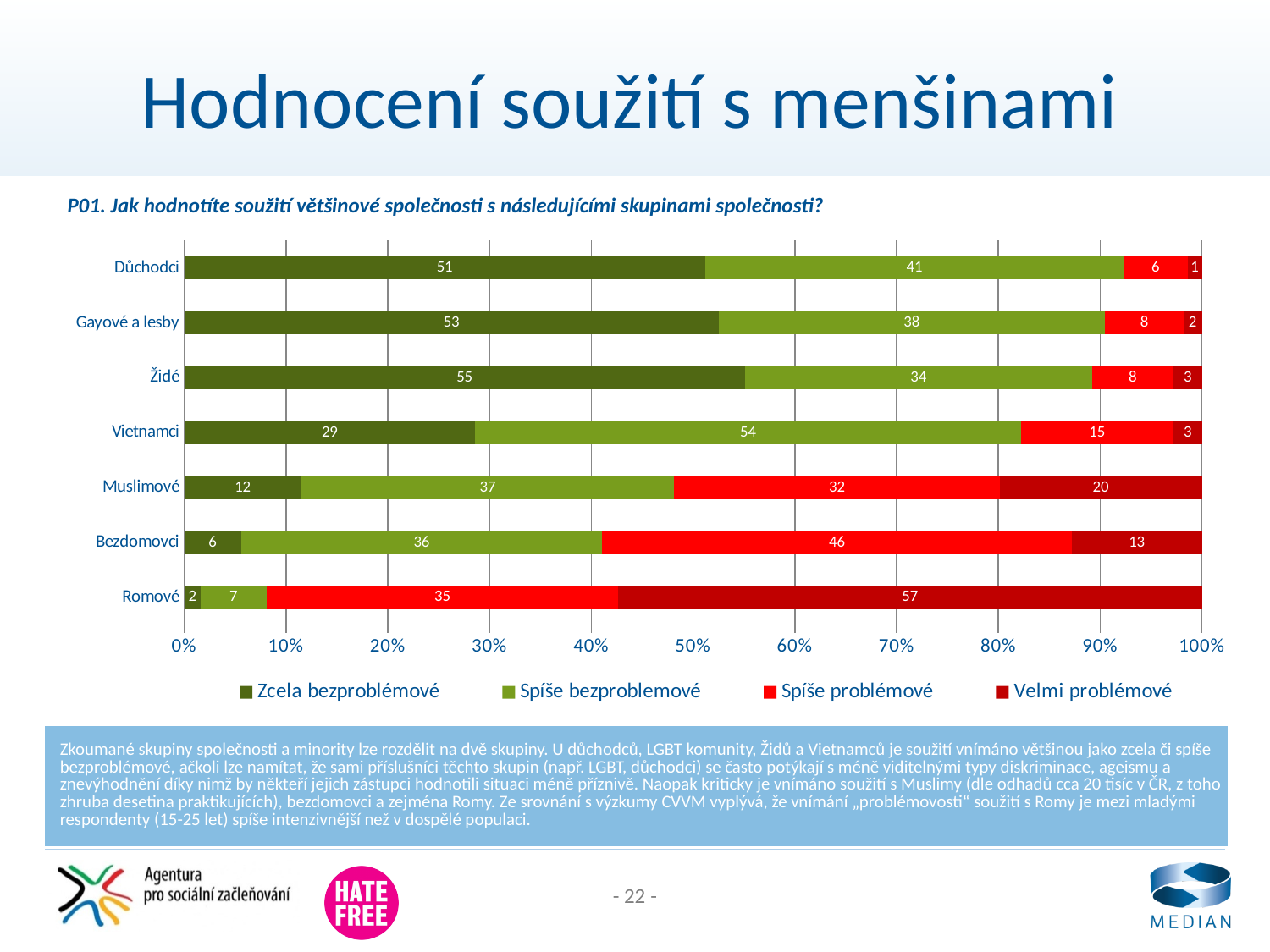
What is the value of "Spíše bezproblemové" for Vietnamci? 54 What type of chart is shown on the slide? stacked bar chart How many series does the legend list? 4 Which group has the lowest "Velmi problémové" value? Důchodci What is the difference between the "Spíše problémové" values for Muslimové and Důchodci? 26 Which group has the highest "Zcela bezproblémové" value? Židé What is the combined value of "Spíše problémové" and "Velmi problémové" for Romové? 92 What is the value of "Velmi problémové" for Romové? 57 How many groups (categories) are plotted on the chart? 7 What is the value of "Spíše problémové" for Bezdomovci? 46 Which is larger: the "Velmi problémové" value for Muslimové or for Bezdomovci? Muslimové What is the value of "Zcela bezproblémové" for Židé? 55